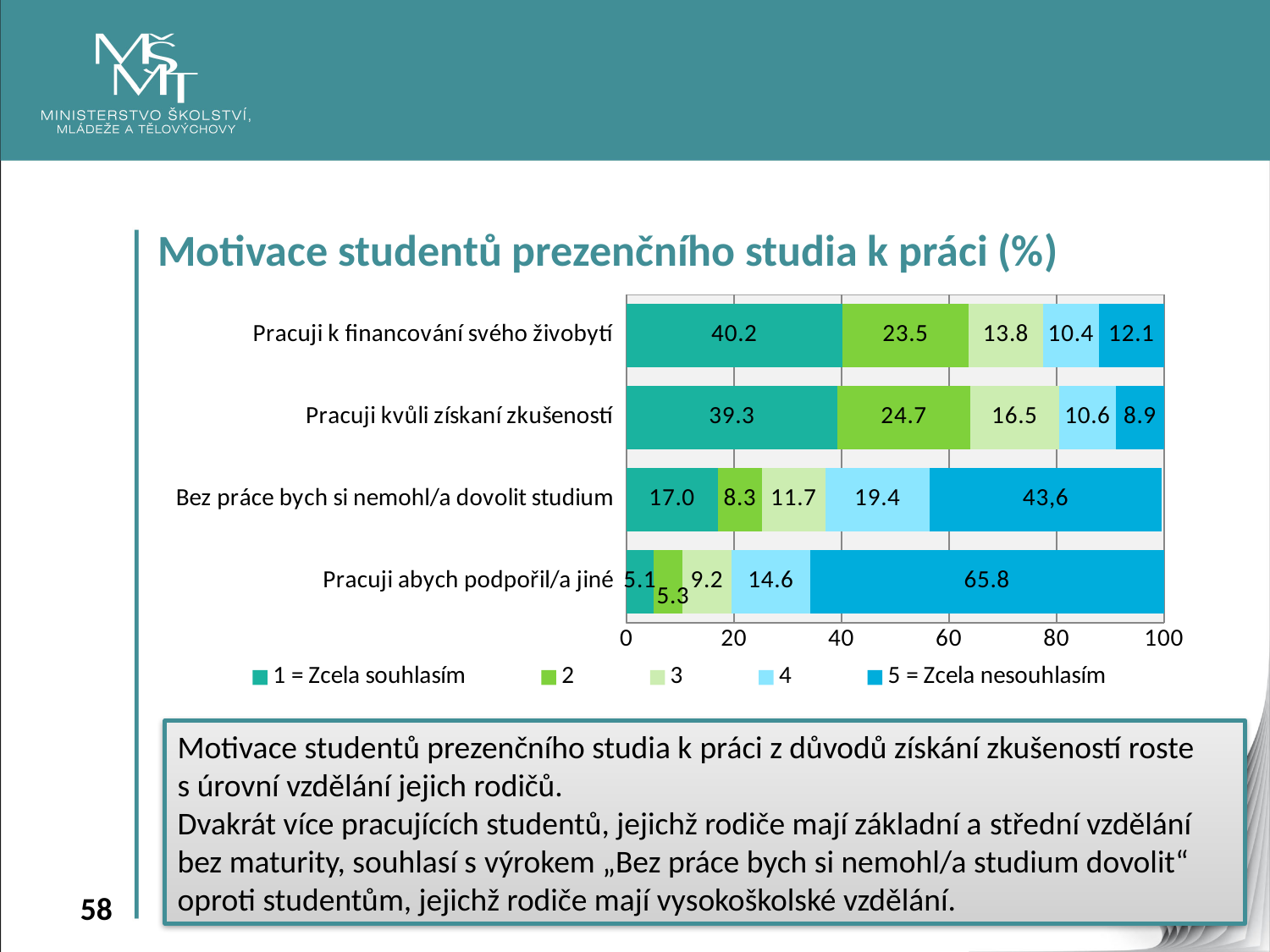
What type of chart is shown on the slide? Stacked bar chart Which statement has the highest value for '5 = Zcela nesouhlasím'? Pracuji abych podpořil/a jiné What is the value of '5 = Zcela nesouhlasím' for 'Bez práce bych si nemohl/a dovolit studium'? 43,6 How many series does the legend list? 5 How many categories (statements) are shown on the chart? 4 What is the value of series '4' for 'Pracuji abych podpořil/a jiné'? 14.6 Which statement has the lowest value for '1 = Zcela souhlasím'? Pracuji abych podpořil/a jiné What is the title of the chart? Motivace studentů prezenčního studia k práci (%) Which is larger: the '2' value for 'Pracuji kvůli získaní zkušeností' or for 'Pracuji k financování svého živobytí'? Pracuji kvůli získaní zkušeností What is the value of '1 = Zcela souhlasím' for 'Pracuji k financování svého živobytí'? 40.2 What is the difference between the '5 = Zcela nesouhlasím' values for 'Pracuji abych podpořil/a jiné' and 'Bez práce bych si nemohl/a dovolit studium'? 22.2 What is the value of series '3' for 'Pracuji kvůli získaní zkušeností'? 16.5